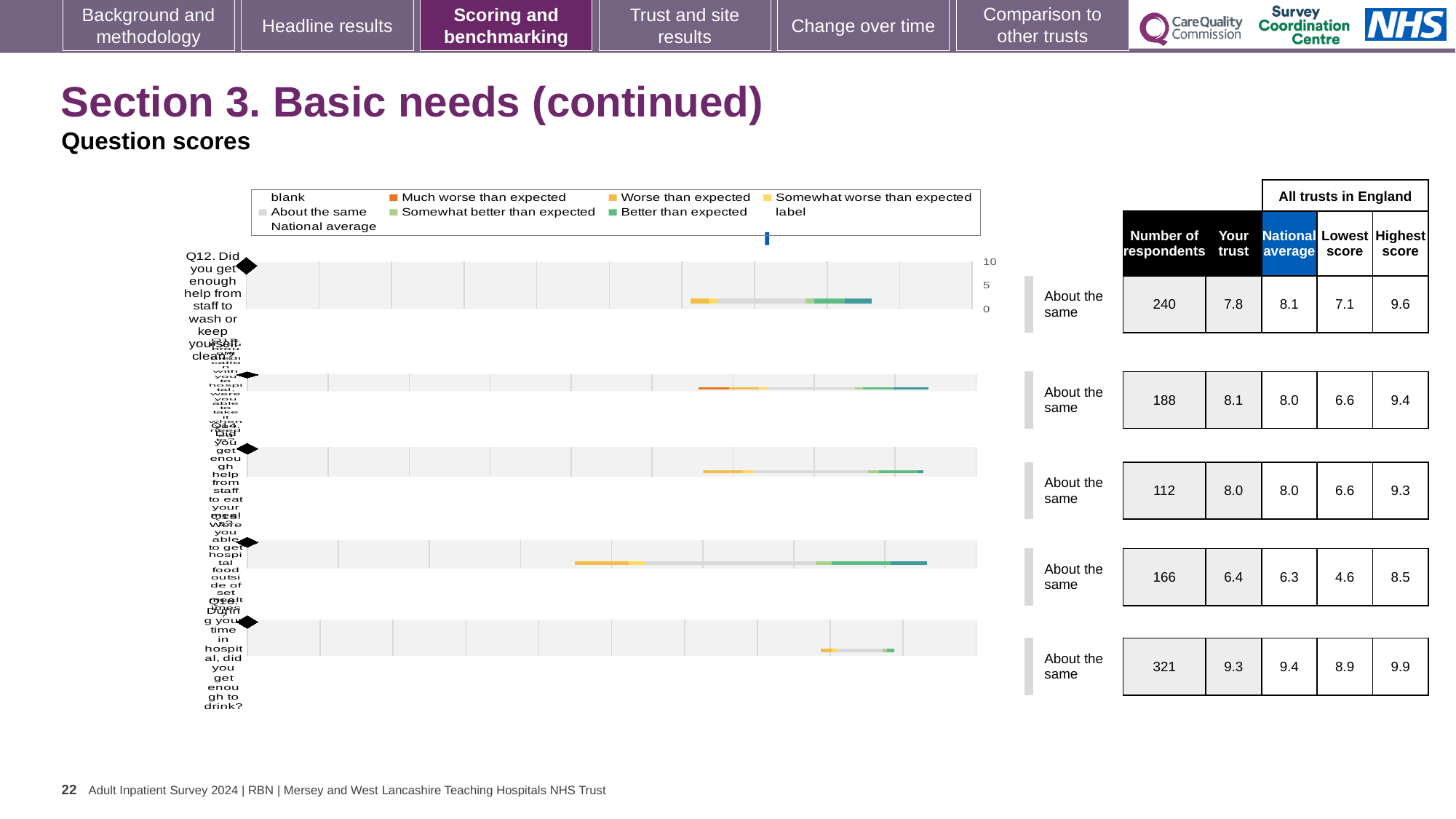
How many question rows are plotted in the chart? 5 How many respondents are listed for Q12 in the table beside the chart? 240 What kind of chart is shown on the slide? bar chart According to the table beside the chart, what is the national average for Q12? 8.1 What benchmark category is shown for every question row in the chart? About the same In the chart legend, what colour represents 'Better than expected'? green What is the difference between the highest score (9.6) and the lowest score (7.1) for Q12 in the table? 2.5 Which row of the table has the highest 'Your trust' score? the fifth (bottom) row, 9.3 In the chart legend, what colour represents 'Much worse than expected'? orange Which row of the table has the lowest 'Your trust' score? the fourth row, 6.4 According to the table beside the chart, what is the 'Your trust' score for Q12 (help from staff to wash or keep yourself clean)? 7.8 For Q12, is the 'Your trust' score higher or lower than the national average? lower